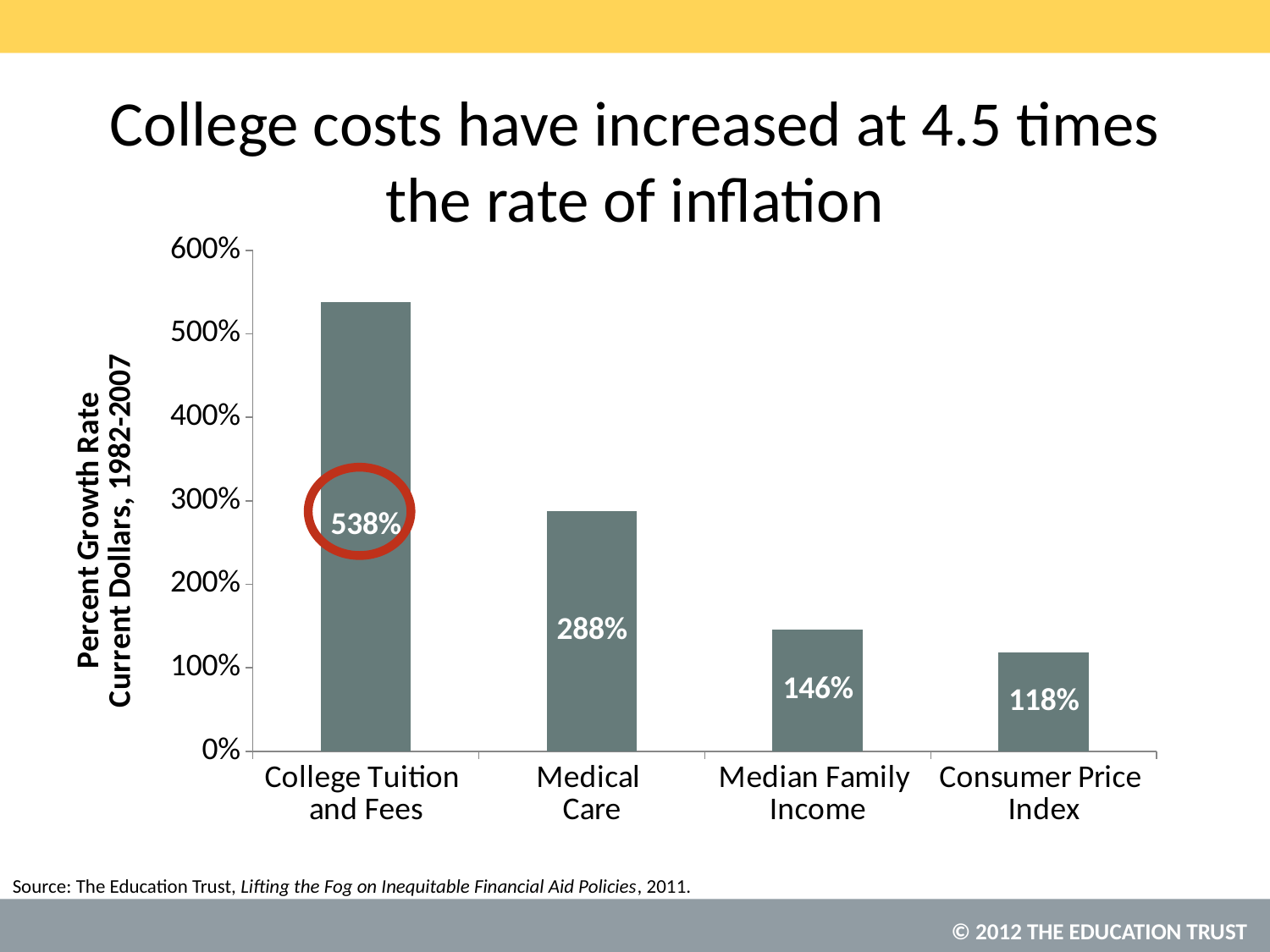
Which category has the highest percent growth rate? College Tuition and Fees What is the percent growth rate for the Consumer Price Index? 118% Which category has the lowest percent growth rate? Consumer Price Index What is the difference between the growth rate for Median Family Income and the growth rate for the Consumer Price Index? 28% How many categories are shown on the chart? 4 What is the difference between the growth rate for College Tuition and Fees and the growth rate for Medical Care? 250% What is the y-axis label of the chart? Percent Growth Rate Current Dollars, 1982-2007 Which is larger, the growth rate for Medical Care or the growth rate for Median Family Income? Medical Care What is the percent growth rate for Medical Care? 288% What is the percent growth rate for Median Family Income? 146% What kind of chart is shown on the slide? Bar chart What is the percent growth rate for College Tuition and Fees? 538%